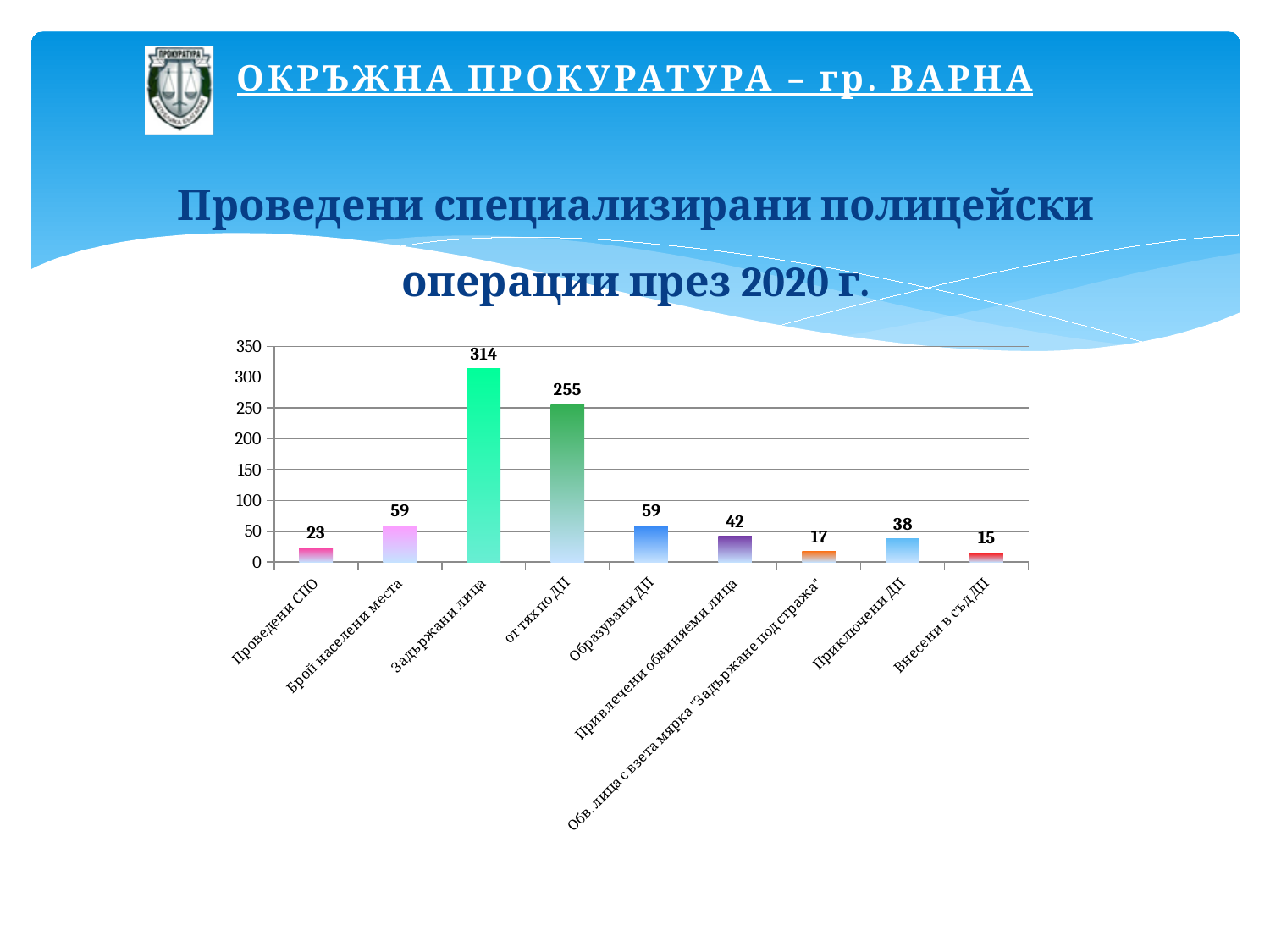
Is the value for от тях по ДП greater or less than 200? greater What is the difference between Задържани лица and от тях по ДП? 59 Which category has the highest value? Задържани лица What is the title of the chart on the slide? Проведени специализирани полицейски операции през 2020 г. What kind of chart is shown on the slide? bar chart What is the value for Приключени ДП? 38 How many categories are shown on the x axis? 9 What is the value for Задържани лица? 314 What is the value for Проведени СПО? 23 What is the difference between Образувани ДП and Внесени в съд ДП? 44 Which category has the lowest value? Внесени в съд ДП Which is larger, Привлечени обвиняеми лица or Приключени ДП? Привлечени обвиняеми лица